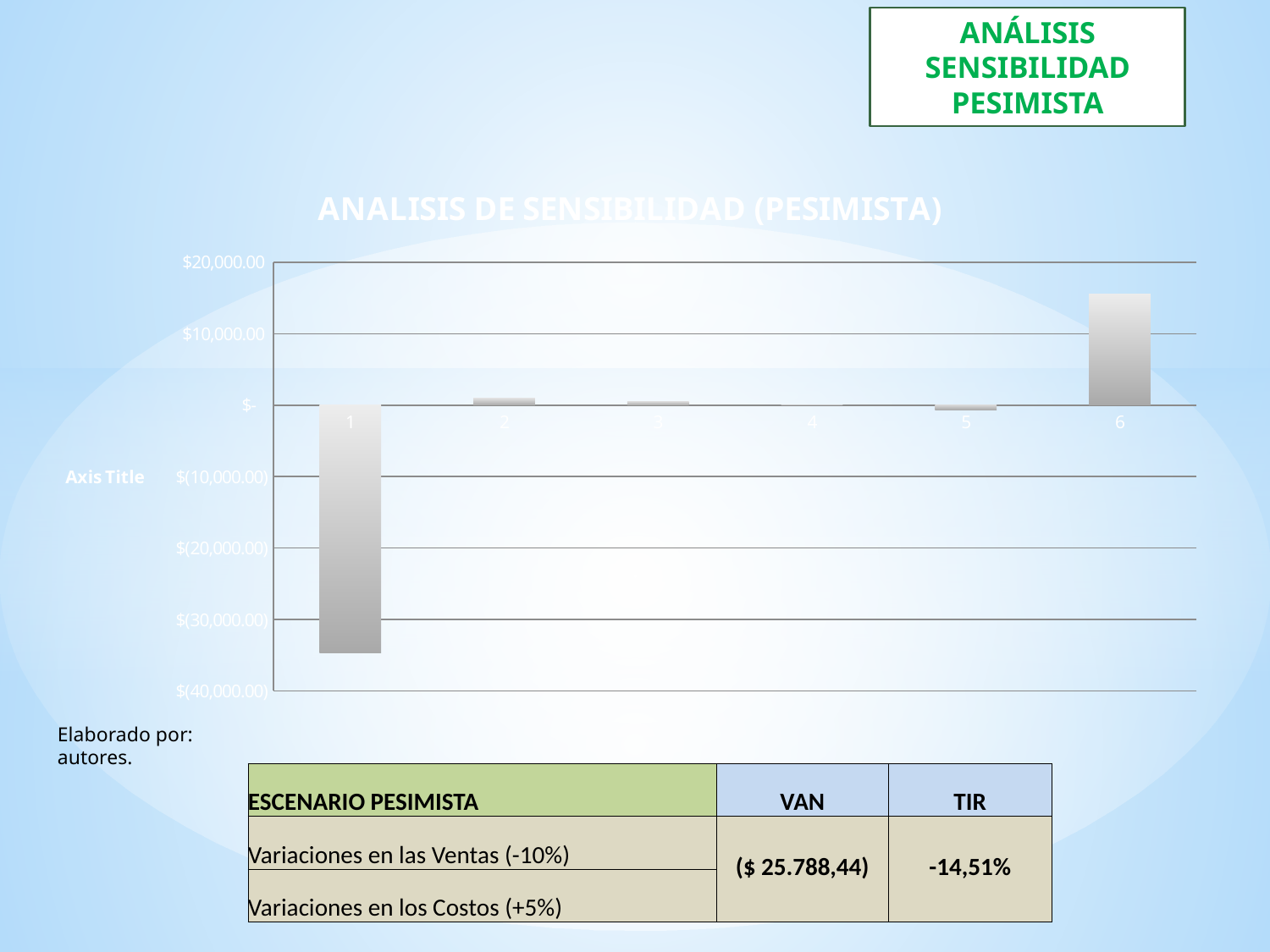
Is the value for category 1 greater or less than $(30,000.00)? less Which category has the highest value in the chart? 6 What is the label shown on the vertical axis of the chart? Axis Title What kind of chart is shown on the slide? bar chart Is the value for category 6 greater or less than $20,000.00? less Is the value for category 6 greater or less than $10,000.00? greater What is the lowest value shown on the vertical axis of the chart? $(40,000.00) How many categories are plotted along the x axis of the chart? 6 Which category has the lowest value in the chart? 1 What is the title of the chart? ANALISIS DE SENSIBILIDAD (PESIMISTA) Which has the larger value, category 2 or category 6? 6 Which has the larger value, category 1 or category 6? 6